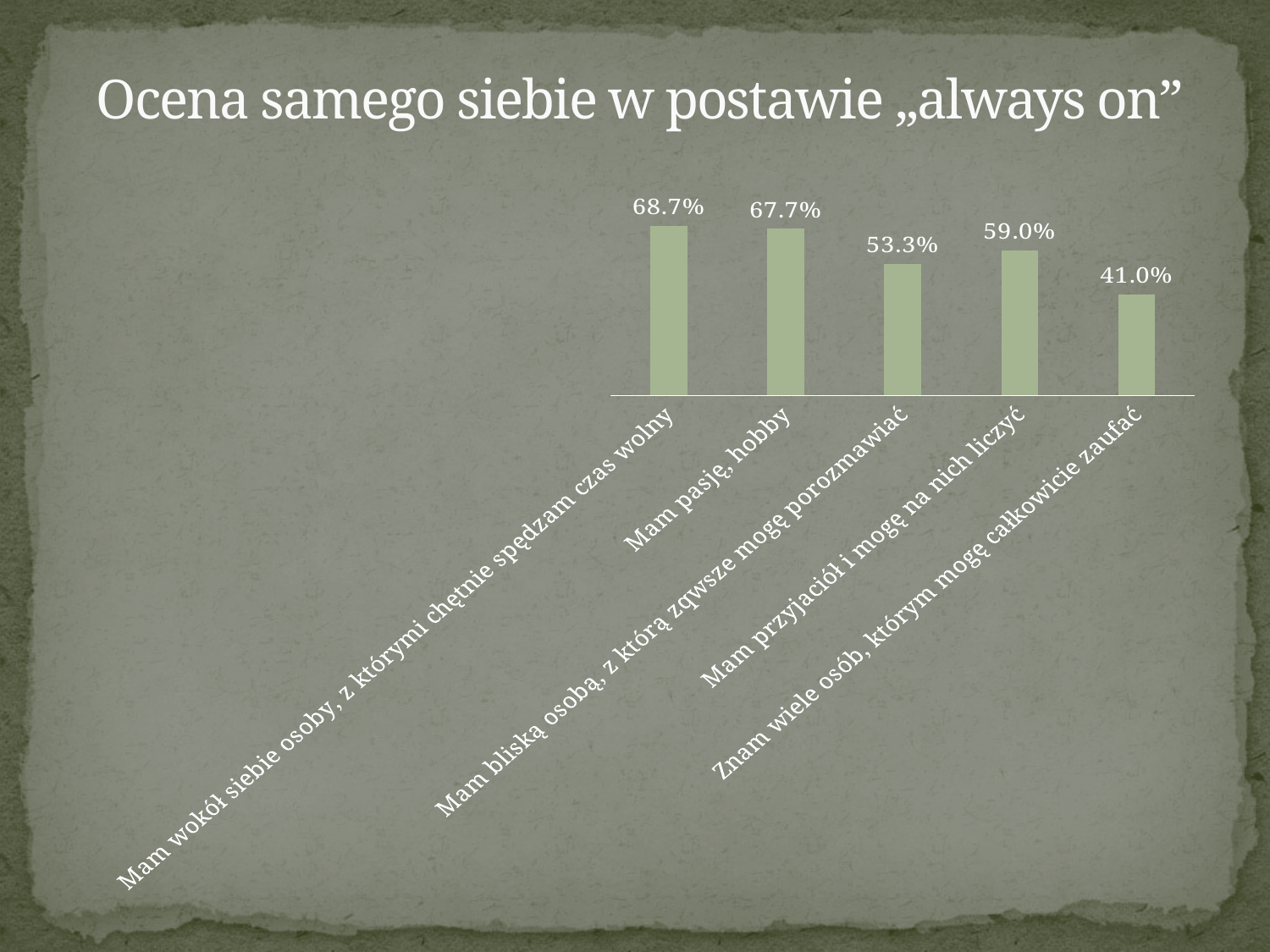
How many categories are shown in the chart? 5 Which is larger: the value for "Mam przyjaciół i mogę na nich liczyć" or for "Mam bliską osobą, z którą zqwsze mogę porozmawiać"? Mam przyjaciół i mogę na nich liczyć What is the value for "Znam wiele osób, którym mogę całkowicie zaufać"? 41.0% What is the title of the slide? Ocena samego siebie w postawie „always on” Which category has the highest value? Mam wokół siebie osoby, z którymi chętnie spędzam czas wolny Which category has the lowest value? Znam wiele osób, którym mogę całkowicie zaufać What is the difference between the values for "Mam pasję, hobby" and "Znam wiele osób, którym mogę całkowicie zaufać"? 26.7% What kind of chart is shown on the slide? Bar chart What is the difference between the values for "Mam przyjaciół i mogę na nich liczyć" and "Mam bliską osobą, z którą zqwsze mogę porozmawiać"? 5.7% What is the value for "Mam przyjaciół i mogę na nich liczyć"? 59.0% What is the value for "Mam bliską osobą, z którą zqwsze mogę porozmawiać"? 53.3% What is the value for "Mam pasję, hobby"? 67.7%